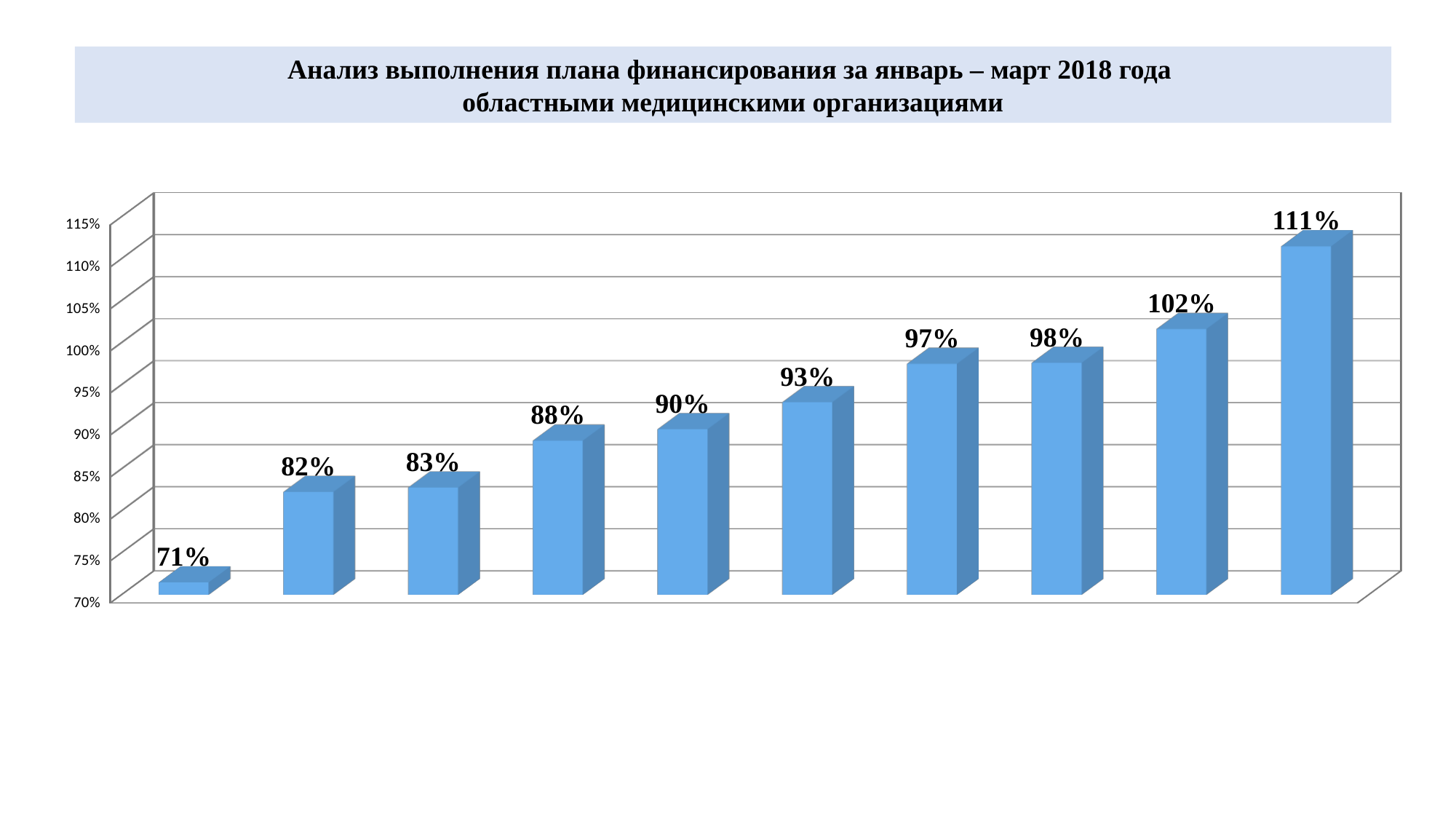
What is the value of the fifth bar from the left? 90% How many bars have a value greater than 100%? 2 What is the difference between the highest and lowest values in the chart? 40% What is the difference between the second bar (82%) and the fourth bar (88%)? 6% What kind of chart is shown on the slide? bar chart What is the lowest value shown in the chart? 71% What is the highest value shown in the chart? 111% What is the value of the first (leftmost) bar? 71% What is the title of the chart? Анализ выполнения плана финансирования за январь – март 2018 года областными медицинскими организациями Do the values rise or fall from left to right along the x axis? rise How many bars are plotted in the chart? 10 What is the value of the last (rightmost) bar? 111%